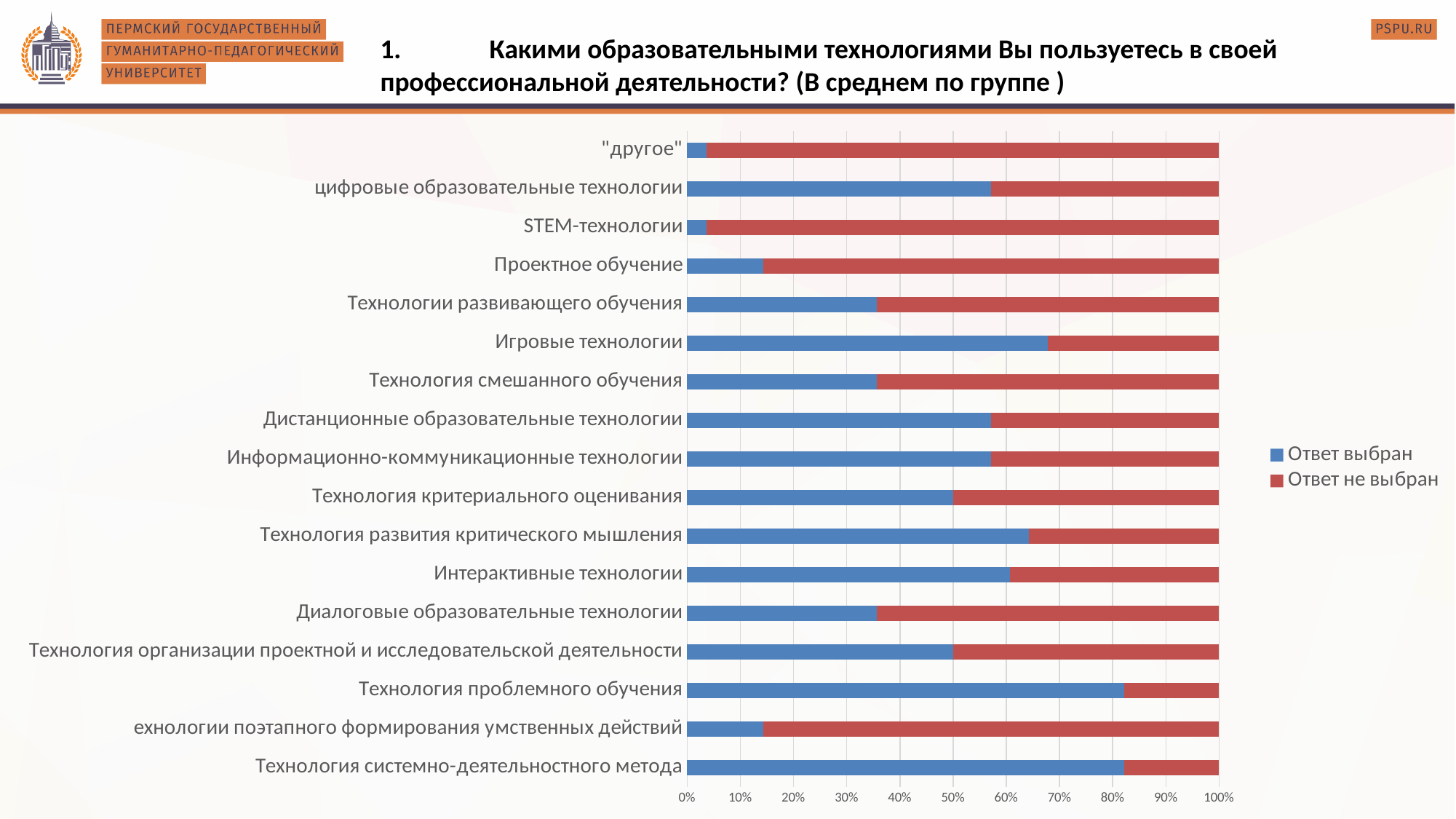
Which has a larger "Ответ выбран" share: Игровые технологии or Проектное обучение? Игровые технологии How many series does the legend list? 2 Which legend entry is shown in blue? Ответ выбран Is the "Ответ выбран" value for Игровые технологии greater or less than 60%? greater What is the total of the stacked bar for Интерактивные технологии? 100% What are the two legend entries of the chart? Ответ выбран; Ответ не выбран What kind of chart is shown on the slide? Stacked bar chart Is the "Ответ выбран" value for STEM-технологии greater or less than 10%? less How many categories (educational technologies) are plotted on the chart? 17 Is the "Ответ выбран" value for Технология проблемного обучения greater or less than 70%? greater Which has a larger "Ответ выбран" share: цифровые образовательные технологии or STEM-технологии? цифровые образовательные технологии